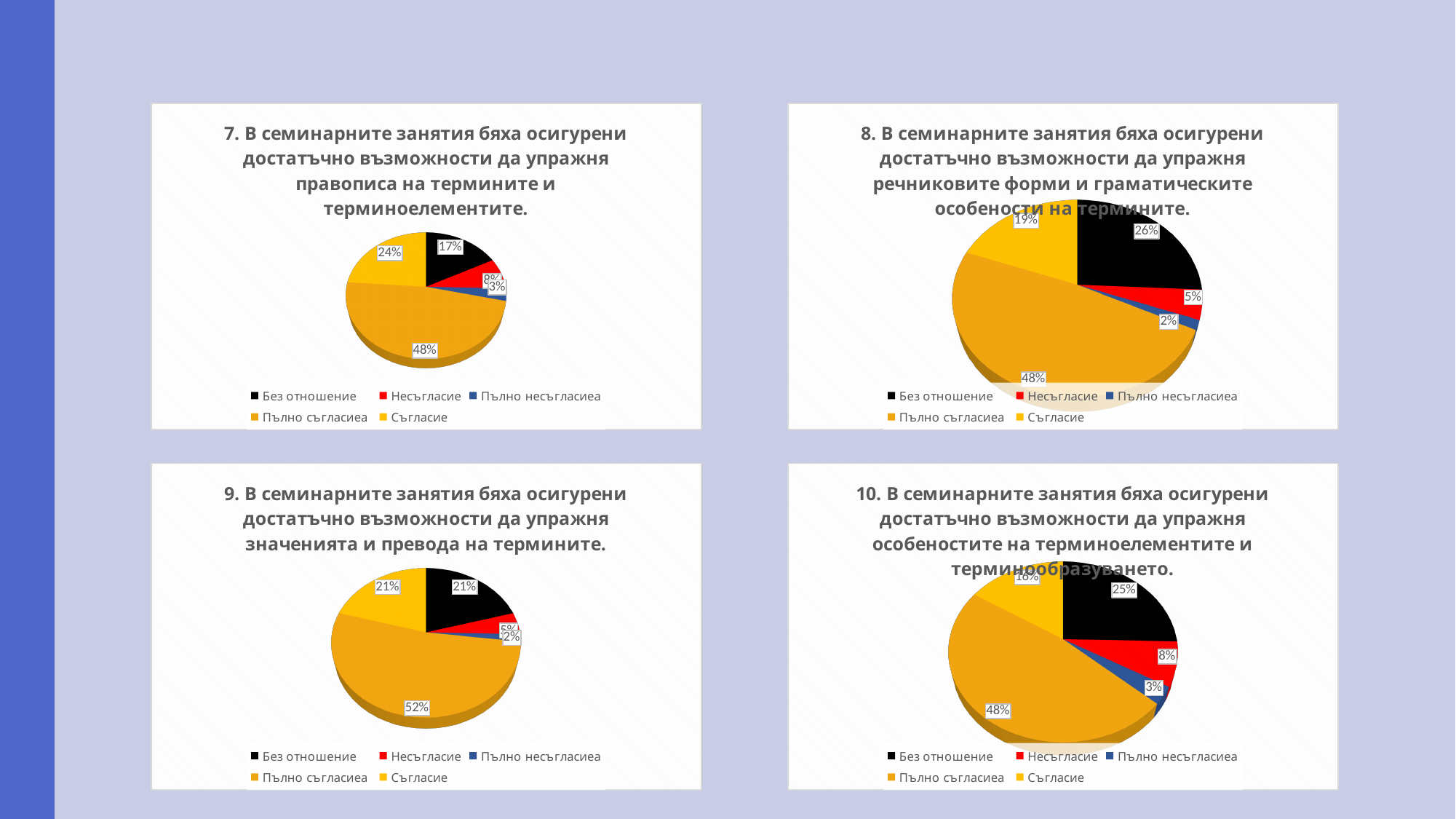
In chart 10 (bottom-right), what is the combined share of 'Несъгласие' and 'Пълно несъгласиеа'? 11% In chart 8 (top-right), what percentage is shown for 'Без отношение'? 26% In chart 10 (bottom-right), which category has the largest slice? Пълно съгласиеа In chart 9 (bottom-left), which is larger: 'Несъгласие' or 'Пълно несъгласиеа'? Несъгласие In chart 7 (top-left), what share of responses is 'Пълно съгласиеа'? 48% How many slices does chart 7 (top-left) have? 5 What type of chart is chart 9 (bottom-left)? Pie chart In chart 8 (top-right), what is the difference between 'Без отношение' and 'Съгласие'? 7% In chart 9 (bottom-left), what is the value for 'Пълно съгласиеа'? 52% In chart 8 (top-right), what colour is the 'Пълно съгласиеа' slice? Orange In chart 10 (bottom-right), what percentage is shown for 'Съгласие'? 16% In chart 7 (top-left), which category has the smallest slice? Пълно несъгласиеа